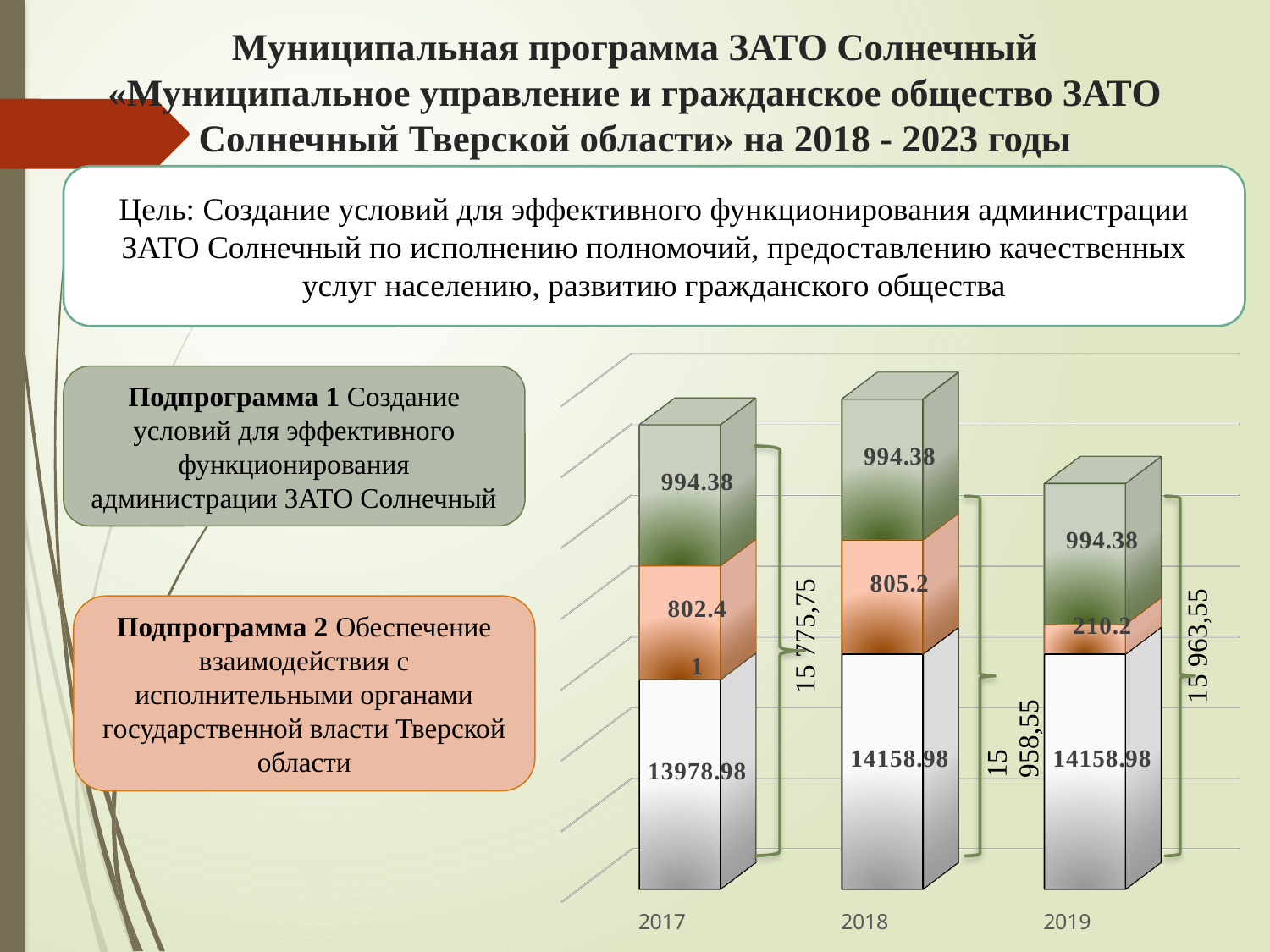
What is the value of the top (green) segment of the 2019 bar? 994.38 How many years (categories) are shown on the x axis of the chart? 3 Which is larger, the bottom (white) segment for 2017 or for 2018? 2018 Does the value of the top (green) segment change from 2017 to 2019? No, it stays at 994.38 What is the value of the bottom (white) segment of the 2017 bar? 13978.98 What is the value of the middle (orange) segment of the 2018 bar? 805.2 Which year labels appear along the x axis of the chart? 2017, 2018, 2019 What is the difference between the bottom (white) segment values for 2018 and 2017? 180 In which year is the middle (orange) segment the smallest? 2019 What kind of chart is shown on the slide? stacked bar chart What is the difference between the middle (orange) segment values for 2018 and 2019? 595 What is the value of the middle (orange) segment of the 2019 bar? 210.2